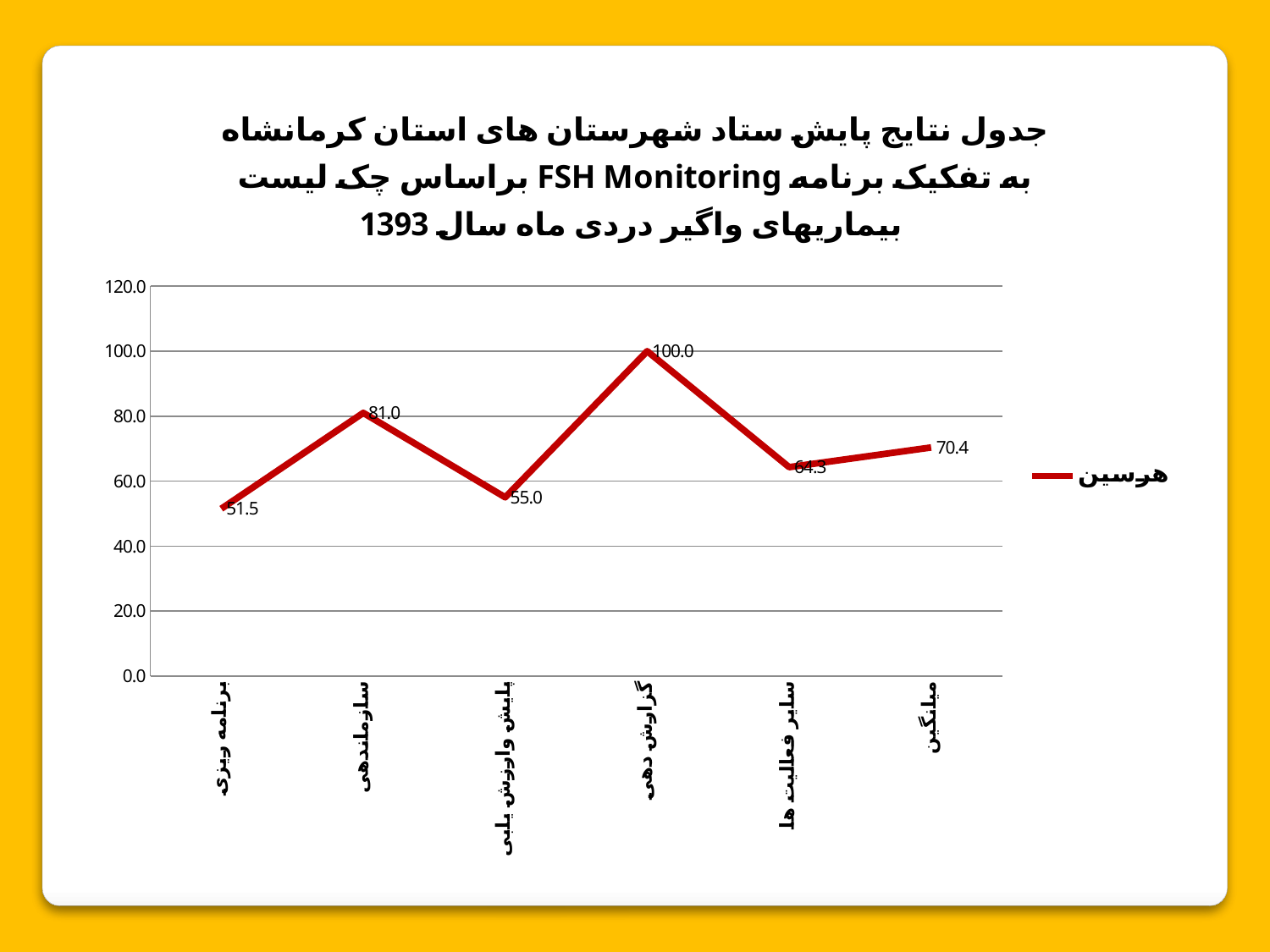
What is the difference between the values for گزارش دهی and سازماندهی? 19.0 What is the value for گزارش دهی? 100.0 Which category has the lowest value? برنامه ریزی Which category has the highest value? گزارش دهی How many categories are plotted on the x axis? 6 What is the name of the series shown in the legend? هرسین What is the value for برنامه ریزی? 51.5 What kind of chart is shown on the slide? line chart How many series does the legend list? 1 Which is larger, the value for سایر فعالیت ها or the value for پایش و ارزشیابی? سایر فعالیت ها What is the value for میانگین? 70.4 What is the value for سازماندهی? 81.0